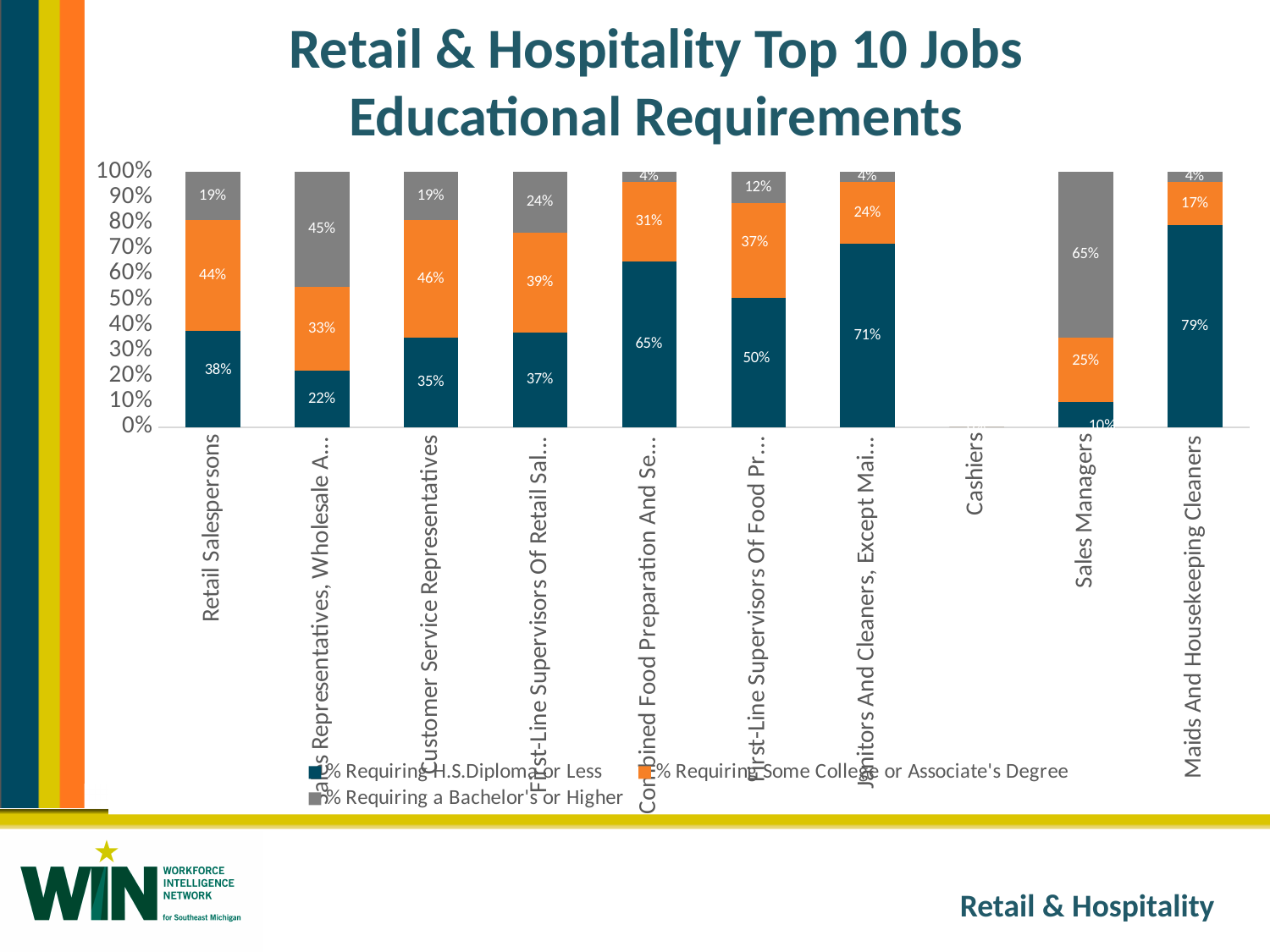
How many job categories are listed on the x axis? 10 What is the difference between the percentage of Sales Managers and Retail Salespersons jobs requiring a Bachelor's or Higher? 46% Which requires a higher percentage of Some College or Associate's Degree: Retail Salespersons or Sales Managers? Retail Salespersons What percentage of Customer Service Representatives jobs require Some College or Associate's Degree? 46% What kind of chart is shown on the slide? Stacked bar chart What is the total of the stacked bar for Maids And Housekeeping Cleaners? 100% What percentage of Retail Salespersons jobs require a H.S. Diploma or Less? 38% What percentage of Maids And Housekeeping Cleaners jobs require a H.S. Diploma or Less? 79% Which job has the lowest percentage requiring a H.S. Diploma or Less among those with a plotted bar? Sales Managers How many series does the legend list? 3 Which job has the highest percentage requiring a H.S. Diploma or Less? Maids And Housekeeping Cleaners What percentage of Sales Managers jobs require a Bachelor's or Higher? 65%